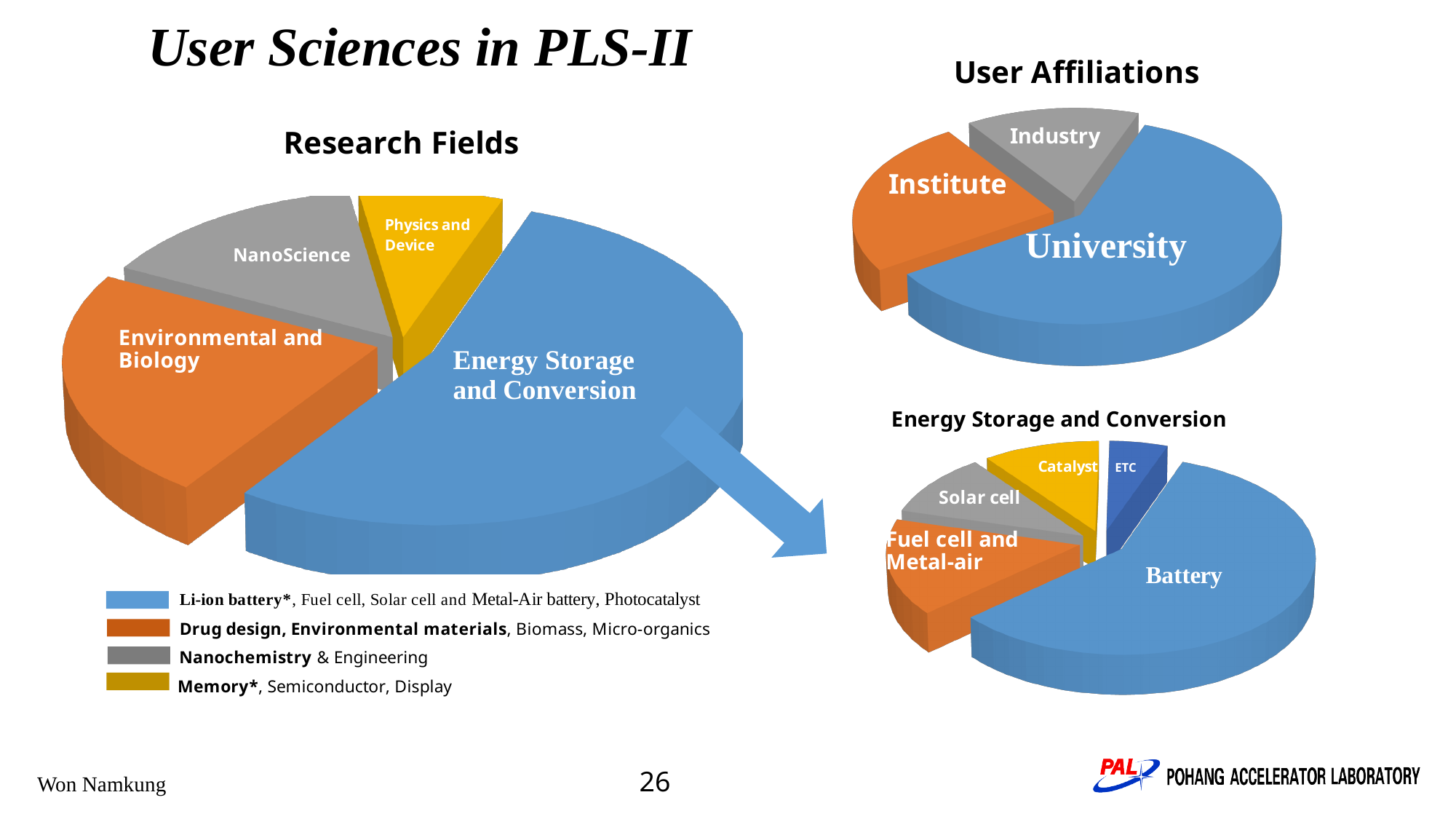
In the Research Fields chart, which slice is larger: Environmental and Biology or NanoScience? Environmental and Biology In the Energy Storage and Conversion chart, which category has the largest share? Battery In the User Affiliations chart, which affiliation has the smallest share? Industry How many slices does the Energy Storage and Conversion pie chart have? 5 What kind of chart is the Research Fields chart? pie chart In the Research Fields chart, which research field has the largest share? Energy Storage and Conversion How many slices does the User Affiliations pie chart have? 3 How many slices does the Research Fields pie chart have? 4 In the Research Fields chart, which research field has the smallest share? Physics and Device In the User Affiliations chart, which slice is larger: Institute or Industry? Institute In the User Affiliations chart, which affiliation has the largest share? University In the Energy Storage and Conversion chart, which slice is larger: Fuel cell and Metal-air or Solar cell? Fuel cell and Metal-air